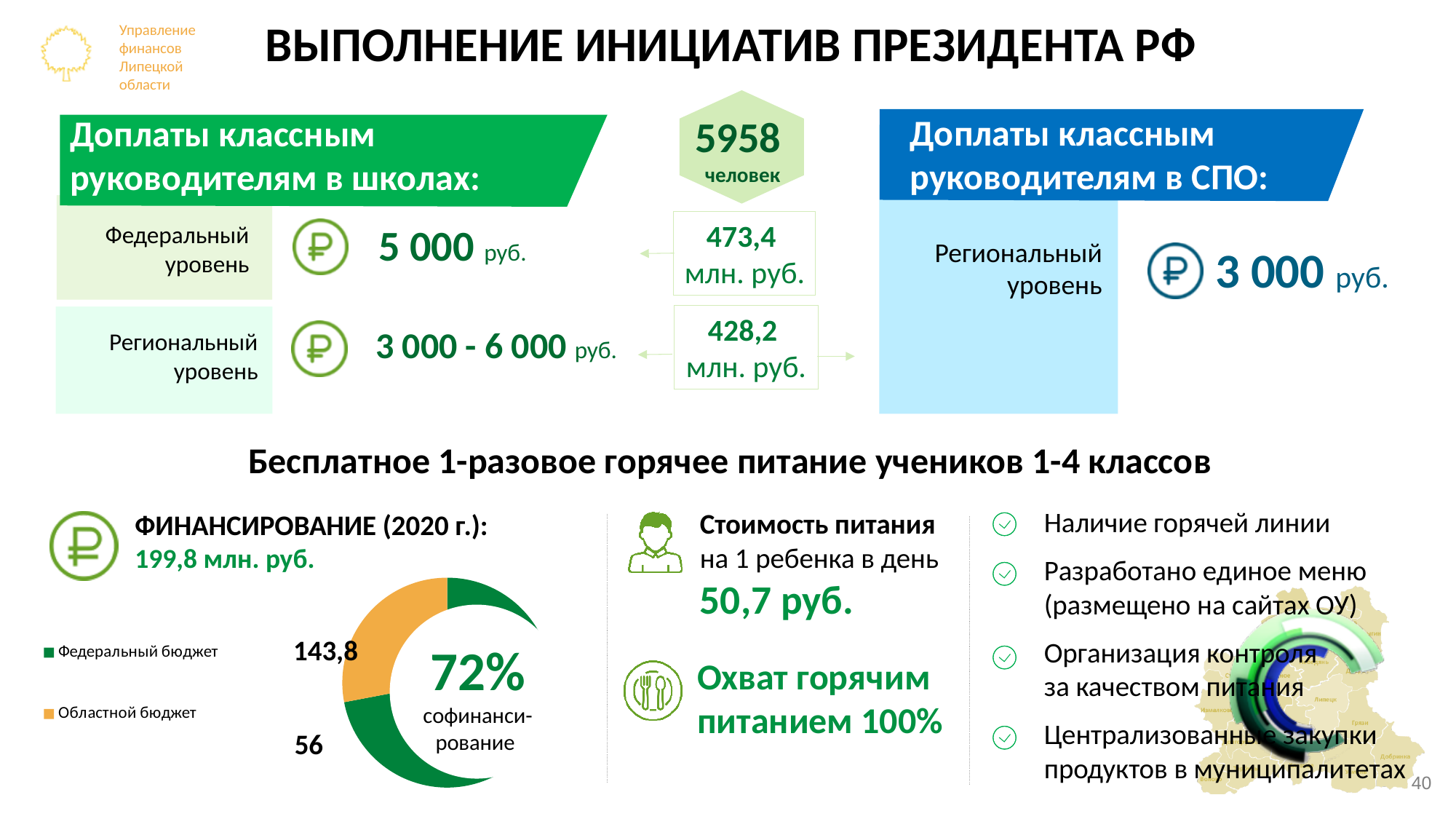
How many slices does the doughnut chart have? 2 What type of chart is shown in the financing section of the slide? Doughnut chart What is the value for Областной бюджет in the doughnut chart? 56 Which category has the smallest slice in the doughnut chart? Областной бюджет How many entries does the legend of the doughnut chart list? 2 Which category has the largest slice in the doughnut chart? Федеральный бюджет What is the difference between the Федеральный бюджет and Областной бюджет values in the doughnut chart? 87,8 What is the total of the two slices in the doughnut chart? 199,8 What share of the doughnut chart does Федеральный бюджет represent, as printed in the centre of the chart? 72% Which is larger in the doughnut chart: Федеральный бюджет or Областной бюджет? Федеральный бюджет What colour is the Областной бюджет slice in the doughnut chart? Orange What is the value for Федеральный бюджет in the doughnut chart? 143,8